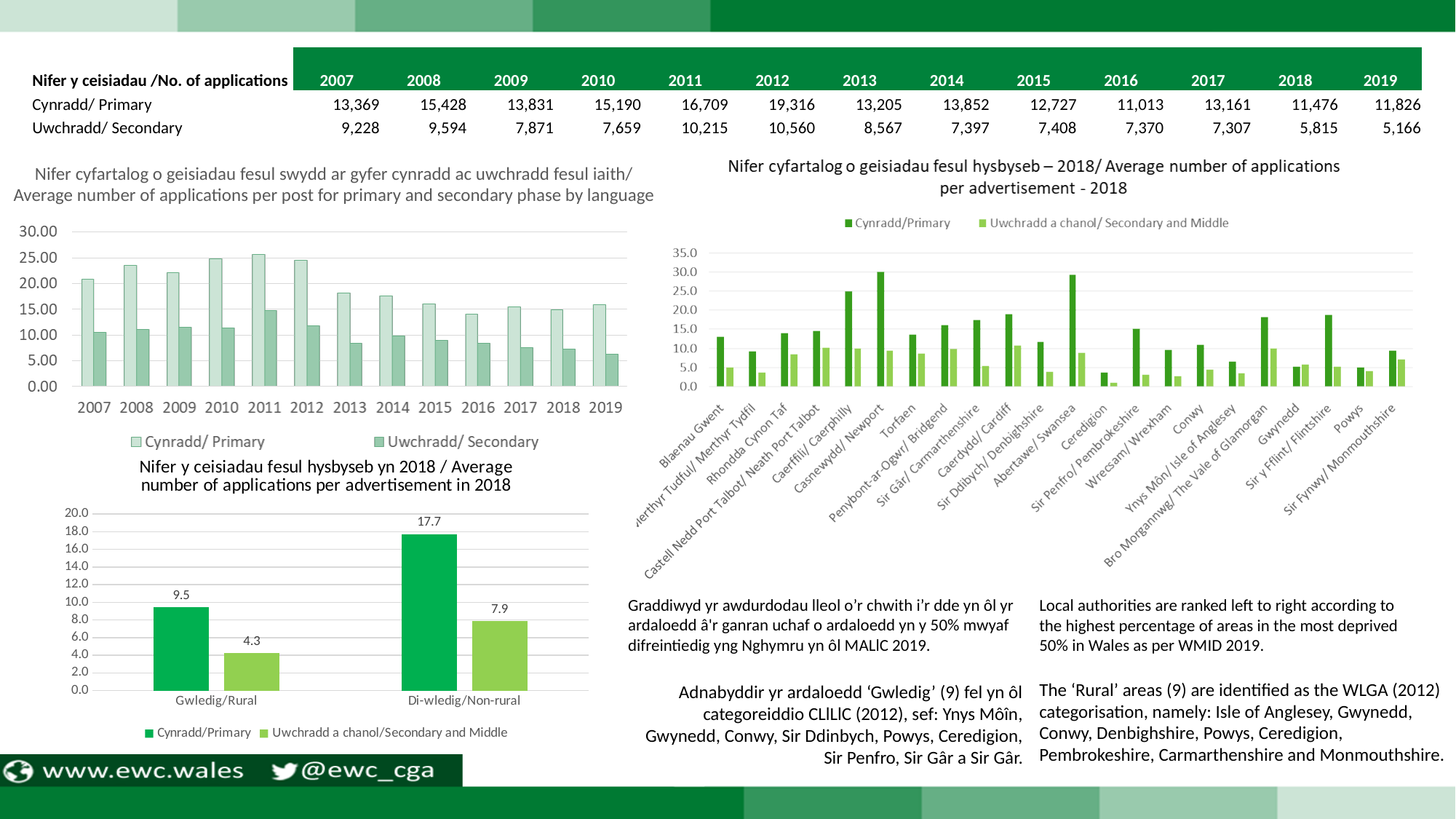
In the chart titled 'Average number of applications per advertisement - 2018' (right), how many local authorities are shown on the x axis? 22 In the chart titled 'Average number of applications per advertisement in 2018' (bottom left), what is the Uwchradd a chanol/Secondary and Middle value for Di-wledig/Non-rural? 7.9 In the chart titled 'Average number of applications per advertisement in 2018' (bottom left), how many series does the legend list? 2 In the chart titled 'Average number of applications per post for primary and secondary phase by language' (top left), how many years are shown on the x axis? 13 In the chart titled 'Average number of applications per post for primary and secondary phase by language' (top left), is the Cynradd/Primary value for 2013 greater or less than 15.00? greater What kind of chart is the chart titled 'Average number of applications per advertisement - 2018' (right)? bar chart In the chart titled 'Average number of applications per advertisement in 2018' (bottom left), what is the difference between the Uwchradd a chanol/Secondary and Middle values for Di-wledig/Non-rural and Gwledig/Rural? 3.6 In the chart titled 'Average number of applications per post for primary and secondary phase by language' (top left), is the Uwchradd/Secondary value for 2019 greater or less than 10.00? less In the chart titled 'Average number of applications per advertisement in 2018' (bottom left), what is the Cynradd/Primary value for Gwledig/Rural? 9.5 In the chart titled 'Average number of applications per advertisement - 2018' (right), is the Cynradd/Primary value for Casnewydd/Newport greater or less than 25.0? greater In the chart titled 'Average number of applications per post for primary and secondary phase by language' (top left), do the Uwchradd/Secondary values generally rise or fall from 2012 to 2019? fall In the chart titled 'Average number of applications per advertisement in 2018' (bottom left), what is the difference between the Cynradd/Primary values for Di-wledig/Non-rural and Gwledig/Rural? 8.2